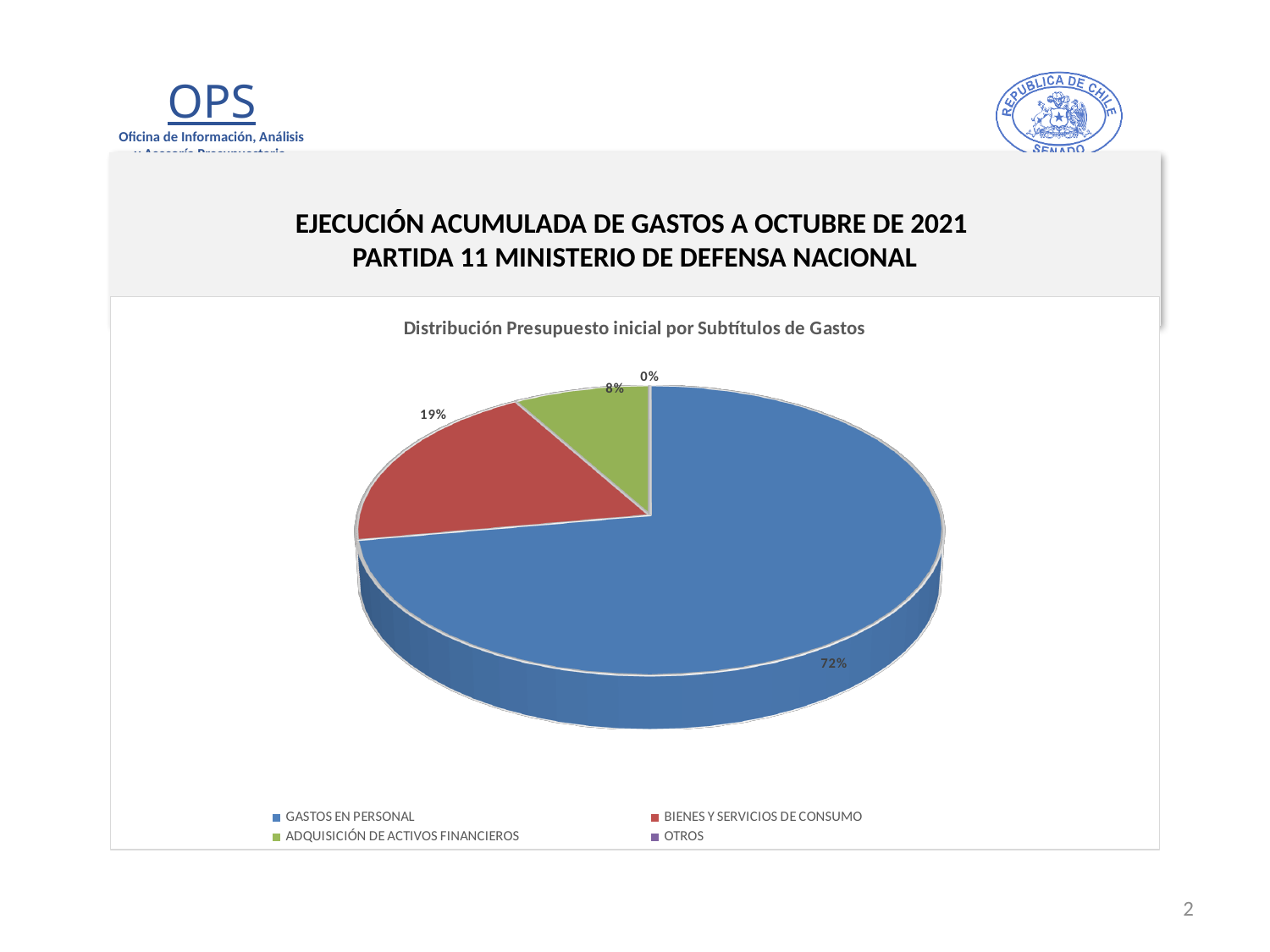
What share of the pie does BIENES Y SERVICIOS DE CONSUMO represent? 19% What is the difference in percentage points between GASTOS EN PERSONAL and BIENES Y SERVICIOS DE CONSUMO? 53 percentage points What share of the pie does GASTOS EN PERSONAL represent? 72% What share of the pie does OTROS represent? 0% Which category has the largest share of the pie? GASTOS EN PERSONAL Which is larger, the share for BIENES Y SERVICIOS DE CONSUMO or the share for ADQUISICIÓN DE ACTIVOS FINANCIEROS? BIENES Y SERVICIOS DE CONSUMO What is the title of the chart? Distribución Presupuesto inicial por Subtítulos de Gastos What colour is the slice for BIENES Y SERVICIOS DE CONSUMO? Red Which category has the smallest share of the pie? OTROS How many categories does the legend list? 4 What kind of chart is shown on the slide? Pie chart